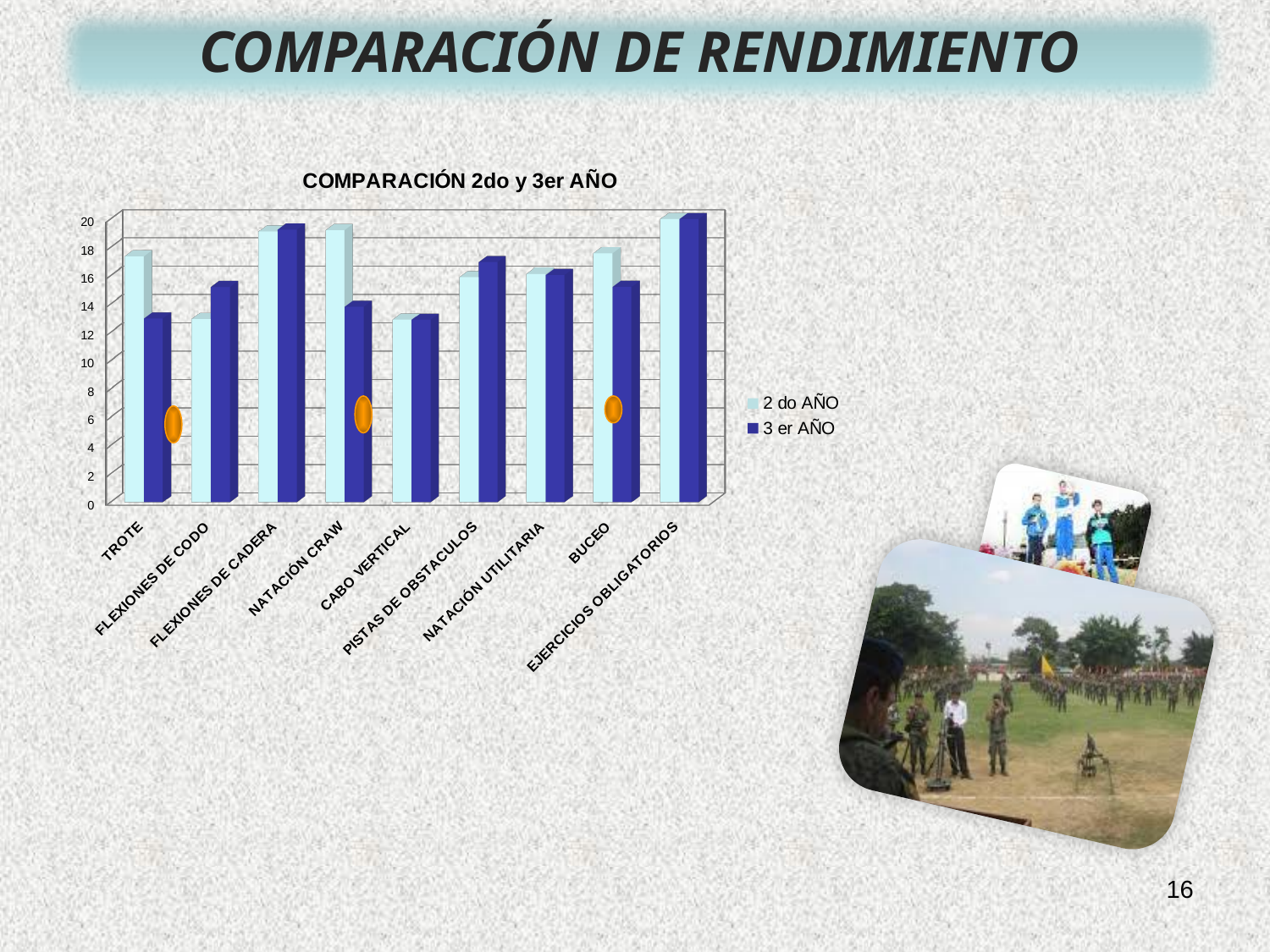
What is the title of the chart? COMPARACIÓN 2do y 3er AÑO For NATACIÓN CRAW, which series has the larger value, 2 do AÑO or 3 er AÑO? 2 do AÑO How many categories are shown on the x axis of the chart? 9 For BUCEO, which series has the larger value, 2 do AÑO or 3 er AÑO? 2 do AÑO How many series does the legend list? 2 Is the 3 er AÑO value for TROTE greater or less than 16? less What type of chart is shown on the slide? Bar chart For TROTE, which series has the larger value, 2 do AÑO or 3 er AÑO? 2 do AÑO Is the 2 do AÑO value for CABO VERTICAL greater or less than 16? less Is the 2 do AÑO value for NATACIÓN CRAW greater or less than 18? greater Which two series are listed in the chart legend? 2 do AÑO and 3 er AÑO